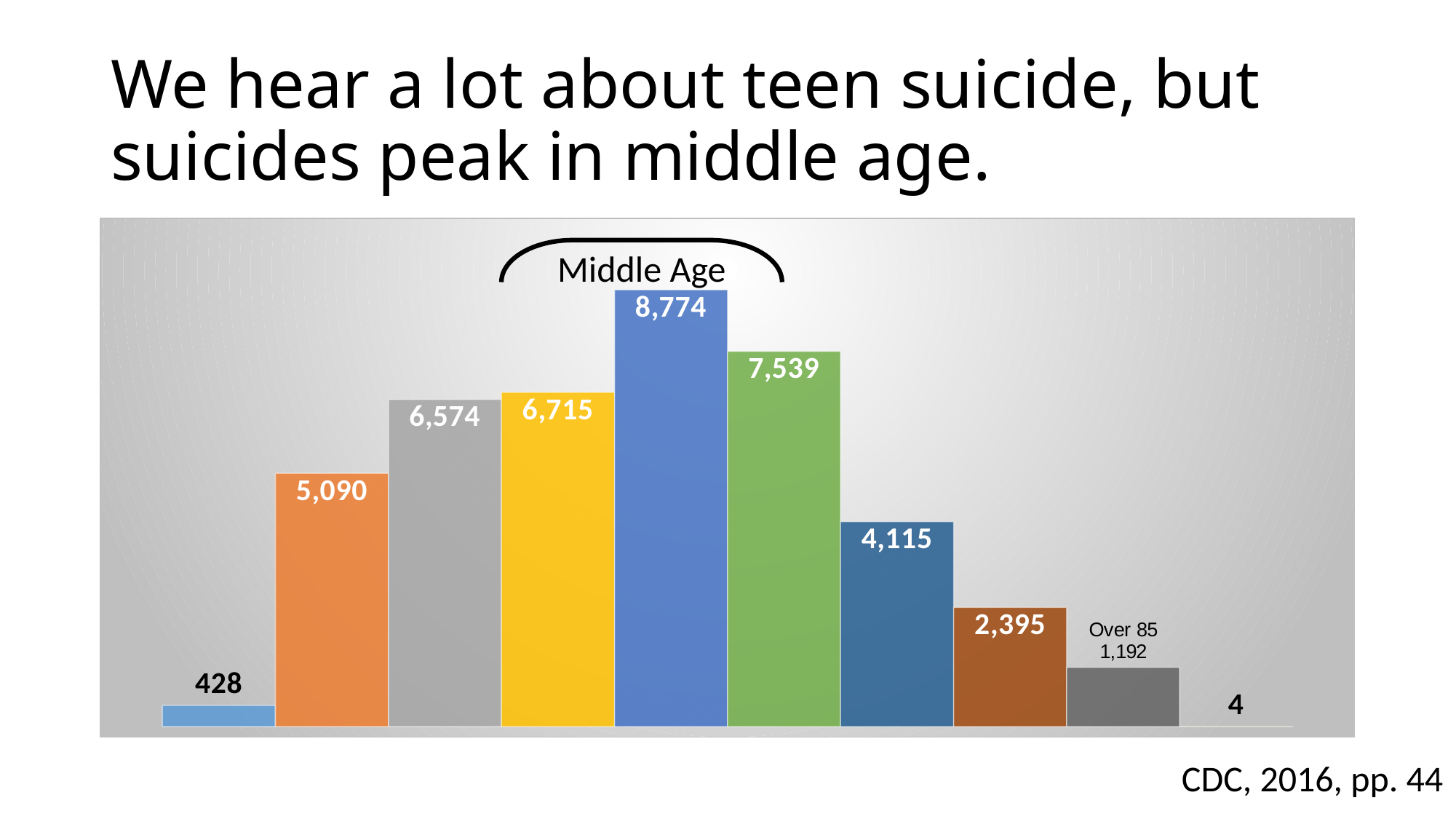
What is the difference between the tallest bar (8,774) and the green bar next to it (7,539)? 1,235 Which is larger, the value of the light grey bar (6,574) or the yellow bar (6,715)? 6,715 What value is shown on the first (leftmost) bar of the chart? 428 What value is shown on the yellow bar? 6,715 How many bars are plotted in the chart? 10 What is the value of the shortest bar in the chart? 4 What kind of chart is shown on the slide? bar chart What label appears in the bracket above the tallest bars of the chart? Middle Age What value is shown for the bar labelled "Over 85"? 1,192 What value is shown on the orange bar, the second from the left? 5,090 What is the value of the tallest bar in the chart? 8,774 What is the difference between the dark blue bar (4,115) and the brown bar (2,395)? 1,720